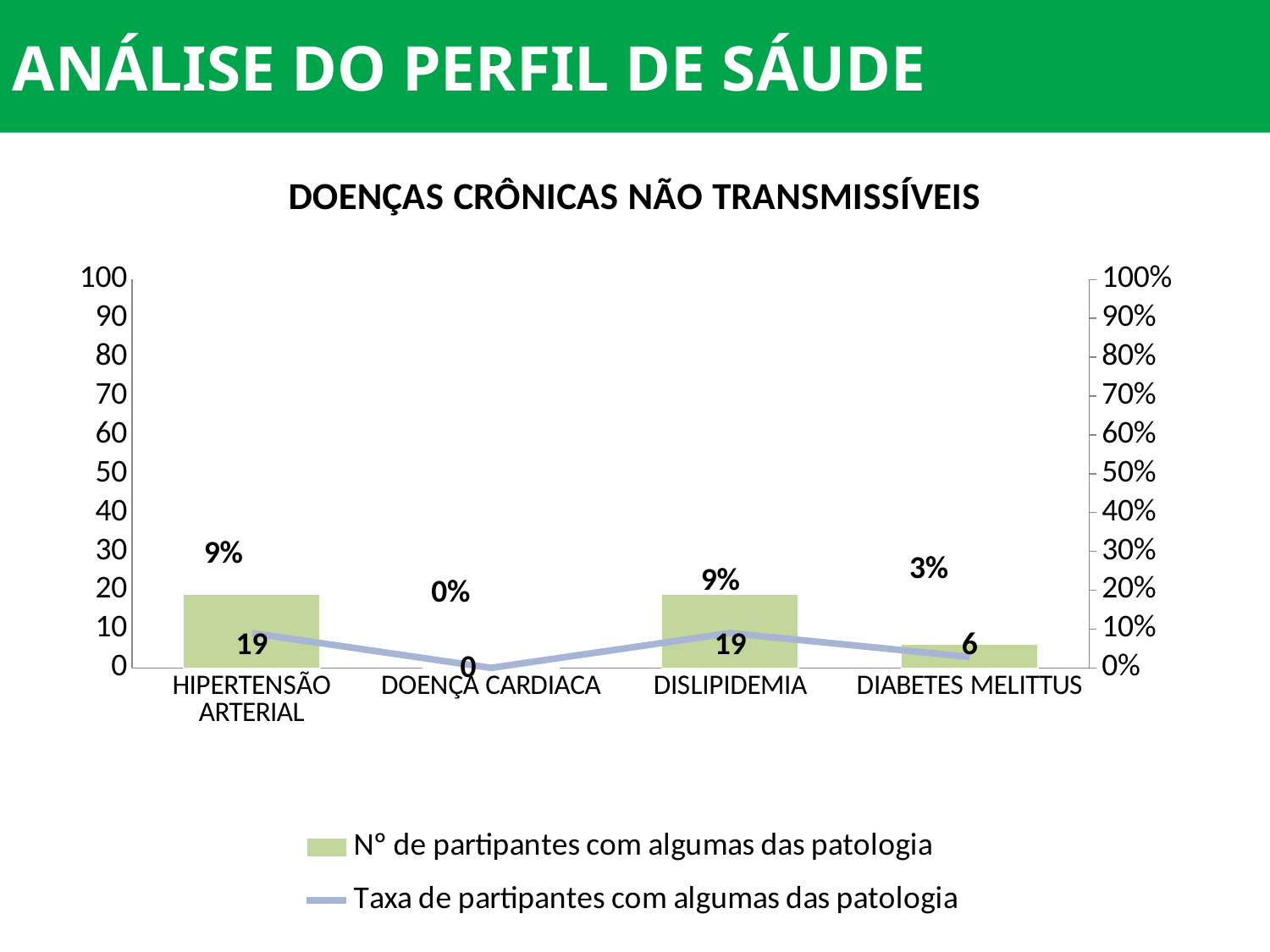
Which has a higher number of participants, DIABETES MELITTUS or HIPERTENSÃO ARTERIAL? HIPERTENSÃO ARTERIAL How many series does the legend list? 2 Is the number of participants for HIPERTENSÃO ARTERIAL greater or less than 30? less What kind of chart is this? A bar chart combined with a line chart What is the title of the chart? DOENÇAS CRÔNICAS NÃO TRANSMISSÍVEIS What is the rate (Taxa de partipantes) shown for DIABETES MELITTUS? 3% Which category has the lowest number of participants? DOENÇA CARDIACA What is the difference between the number of participants for DISLIPIDEMIA and for DIABETES MELITTUS? 13 What is the number of participants shown for DISLIPIDEMIA? 19 What is the rate (Taxa de partipantes) shown for DOENÇA CARDIACA? 0% What is the number of participants with hypertensão arterial (Nº de partipantes)? 19 How many categories are shown on the x axis? 4